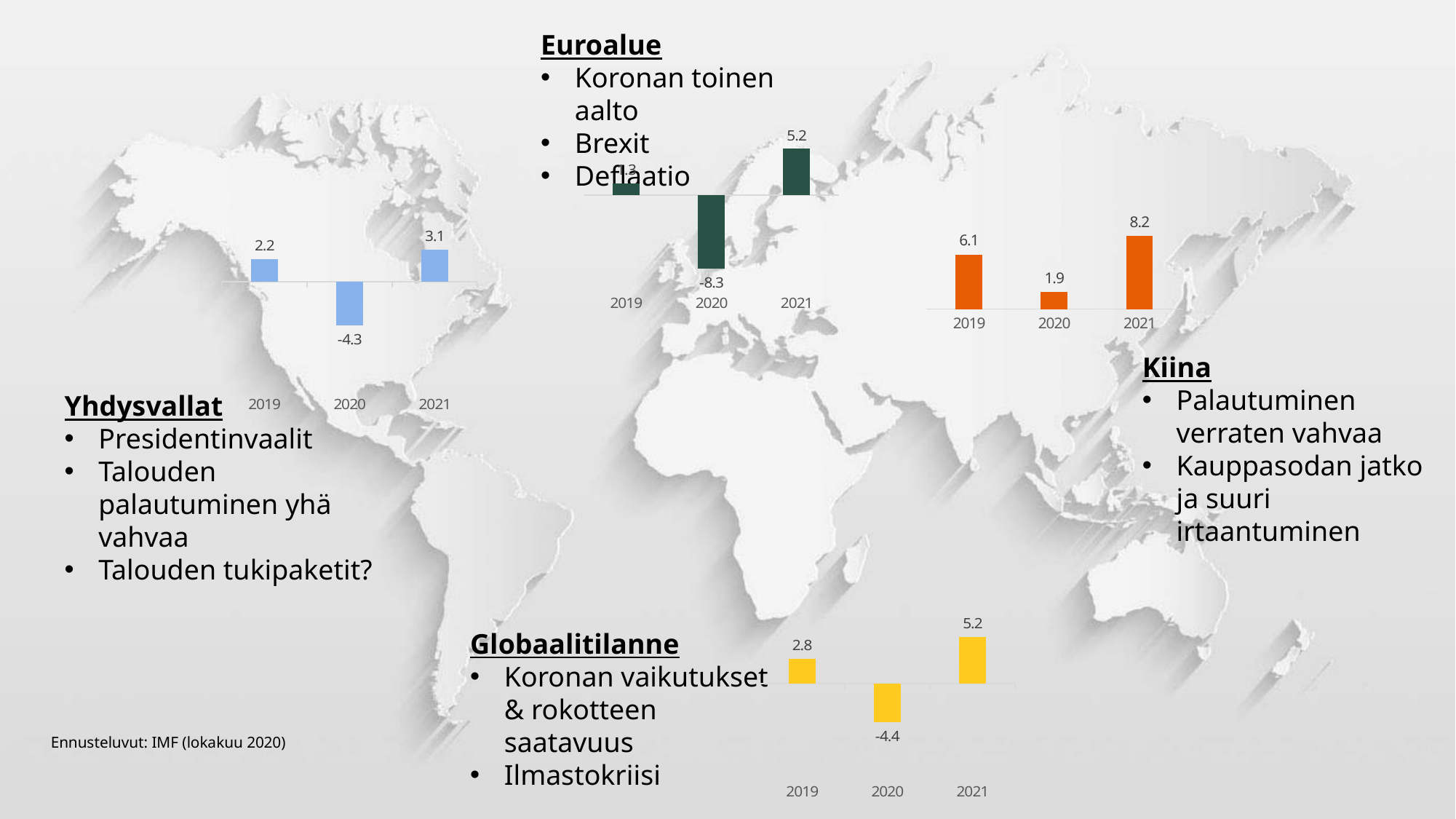
In the blue bar chart over North America (Yhdysvallat), what is the value for 2020? -4.3 In the dark green bar chart over Europe (Euroalue), what is the value for 2021? 5.2 Which is larger: the 2021 value in the blue chart (Yhdysvallat) or the 2021 value in the orange chart (Kiina)? Kiina (8.2) In the orange bar chart over Asia (Kiina), what is the difference between the 2021 and 2019 values? 2.1 In the dark green bar chart over Europe (Euroalue), what is the value for 2020? -8.3 In the yellow bar chart at the bottom (Globaalitilanne), what is the difference between the 2021 and 2020 values? 9.6 How many years are shown on the x axis of the blue bar chart over North America (Yhdysvallat)? 3 In the yellow bar chart at the bottom (Globaalitilanne), which year has the lowest value? 2020 In the orange bar chart over Asia (Kiina), what is the value for 2020? 1.9 In the yellow bar chart at the bottom (Globaalitilanne), what is the value for 2019? 2.8 In the blue bar chart over North America (Yhdysvallat), what is the value for 2021? 3.1 In the orange bar chart over Asia (Kiina), which year has the highest value? 2021